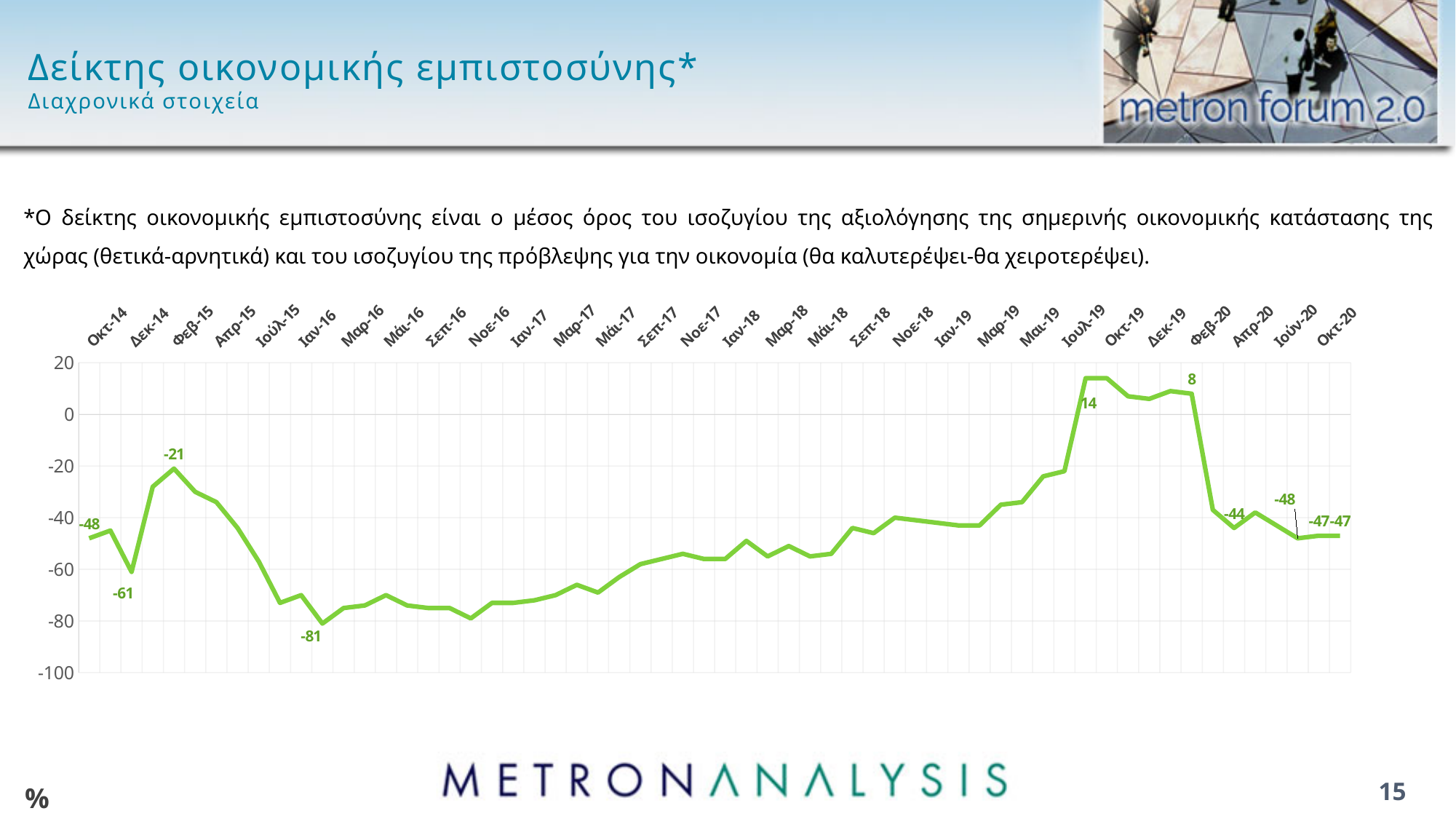
What is the value of the index at Οκτ-14, the first point on the chart? -48 What is the difference between the highest labelled value (14) and the lowest labelled value (-81)? 95 Is the value for Μαι-19 greater or less than -40? greater Which is larger, the value at Οκτ-14 or the value at Οκτ-20? Οκτ-20 Does the index generally rise or fall between Ιαν-16 and Ιουλ-19? rise What is the difference between the labelled values -21 and -81? 60 What type of chart is shown on the slide? line chart Is the value for Ιαν-17 greater or less than -60? less What is the title of the slide containing the chart? Δείκτης οικονομικής εμπιστοσύνης* What is the lowest value shown on the line chart? -81 What is the value of the index at Οκτ-20, the last point on the chart? -47 What is the highest value shown on the line chart? 14